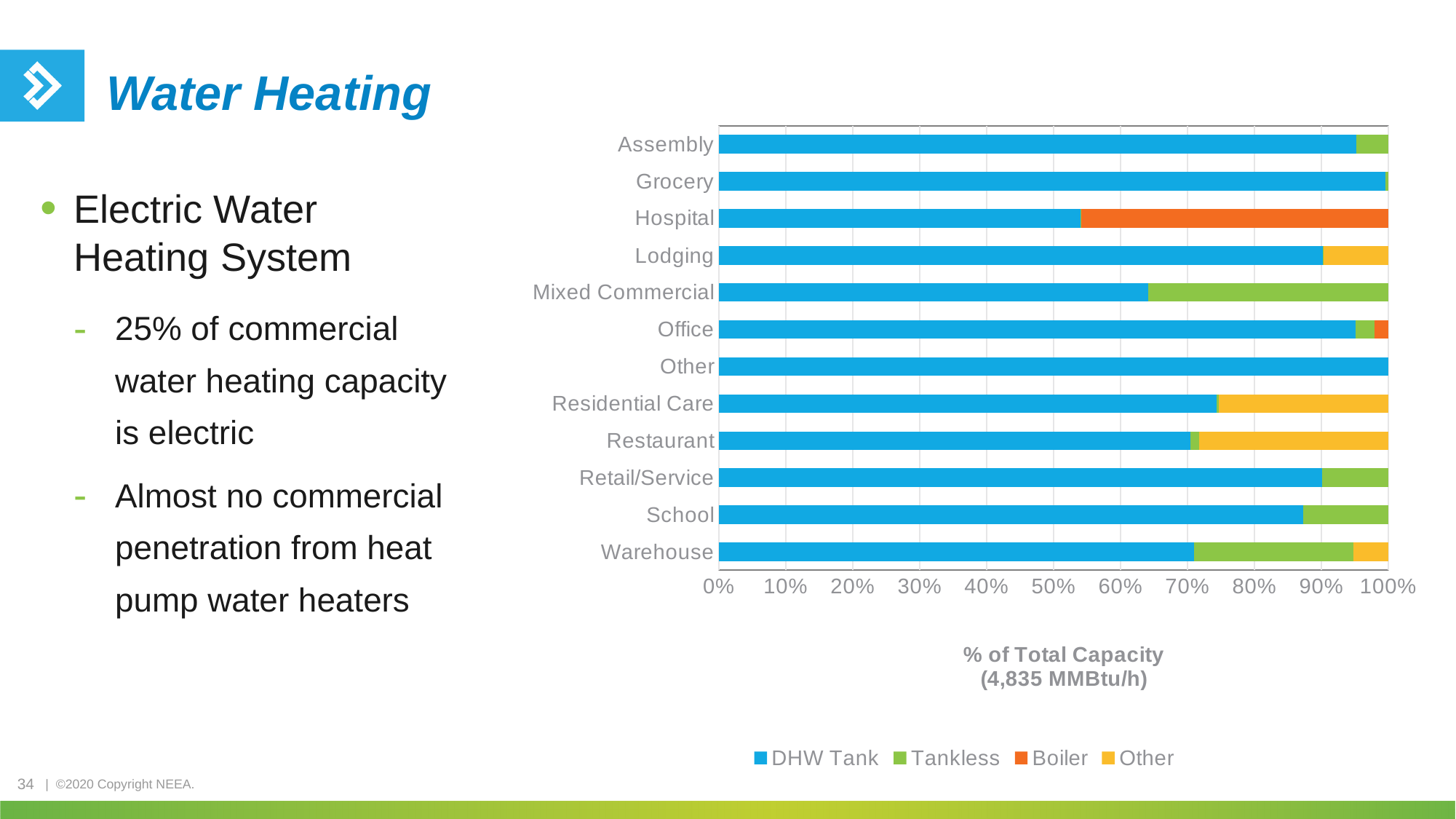
Is the DHW Tank share for Residential Care greater or less than 70%? greater Which category has the lowest DHW Tank share of total capacity? Hospital What is the title of the horizontal axis? % of Total Capacity (4,835 MMBtu/h) How many building categories are plotted on the chart? 12 Is the DHW Tank share for Mixed Commercial greater or less than 70%? less What kind of chart is shown on the slide? Stacked bar chart Which category has the largest Boiler share of total capacity? Hospital Is the DHW Tank share for Hospital greater or less than 50%? greater Which series is shown in orange in the legend? Boiler Which has a larger DHW Tank share: Hospital or Mixed Commercial? Mixed Commercial How many series does the chart legend list? 4